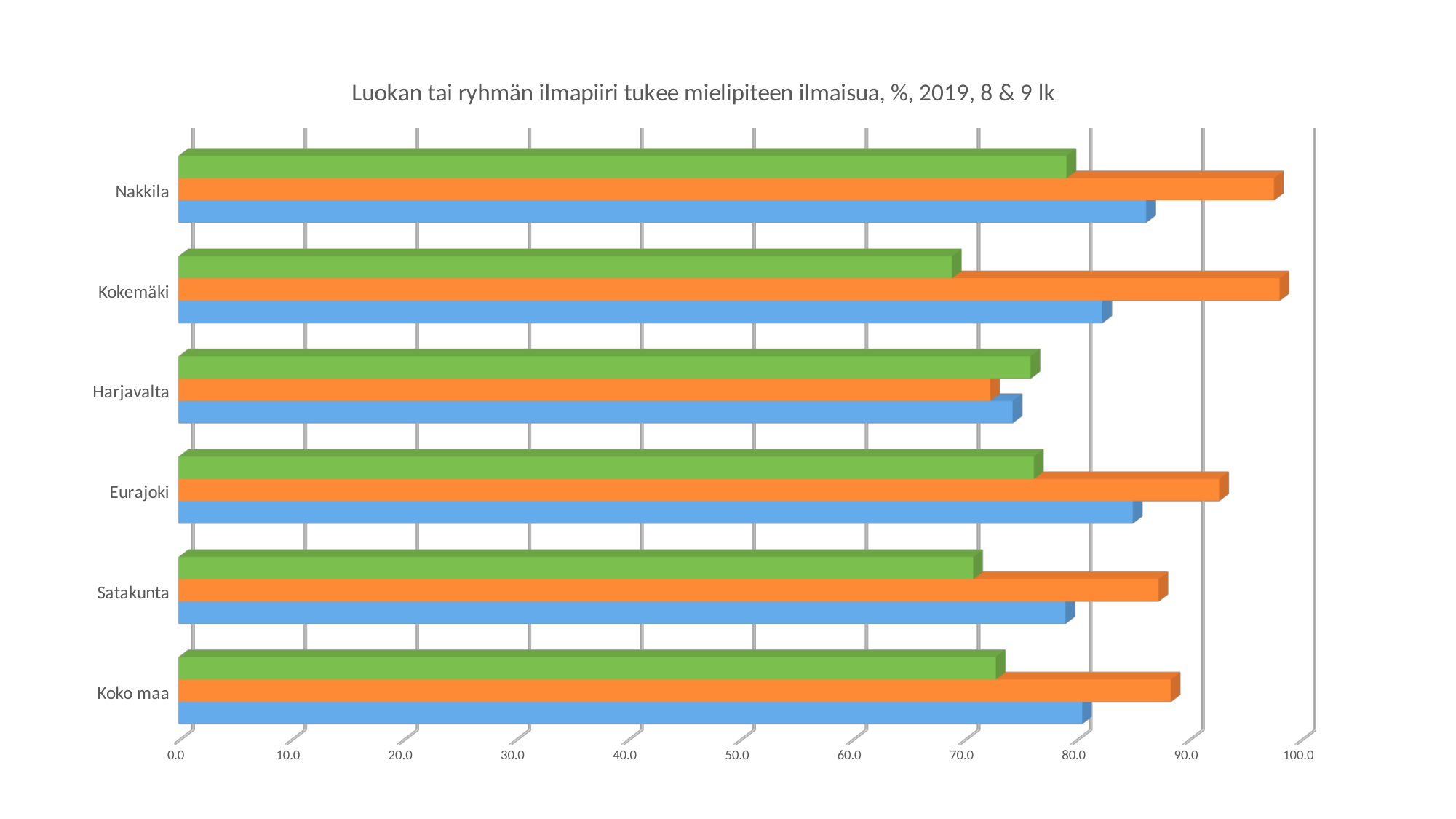
Is the orange bar for Nakkila greater or less than 90? greater Which category has the lowest value for the orange series? Harjavalta Is the green bar for Kokemäki greater or less than 80? less For Kokemäki, which is larger: the orange bar or the green bar? the orange bar Is the orange bar for Harjavalta greater or less than 80? less What is the title of the chart? Luokan tai ryhmän ilmapiiri tukee mielipiteen ilmaisua, %, 2019, 8 & 9 lk How many categories (areas) are shown on the chart? 6 Which category has the lowest value for the blue series? Harjavalta Which is larger: the orange bar for Nakkila or the orange bar for Harjavalta? Nakkila What kind of chart is shown on the slide? bar chart